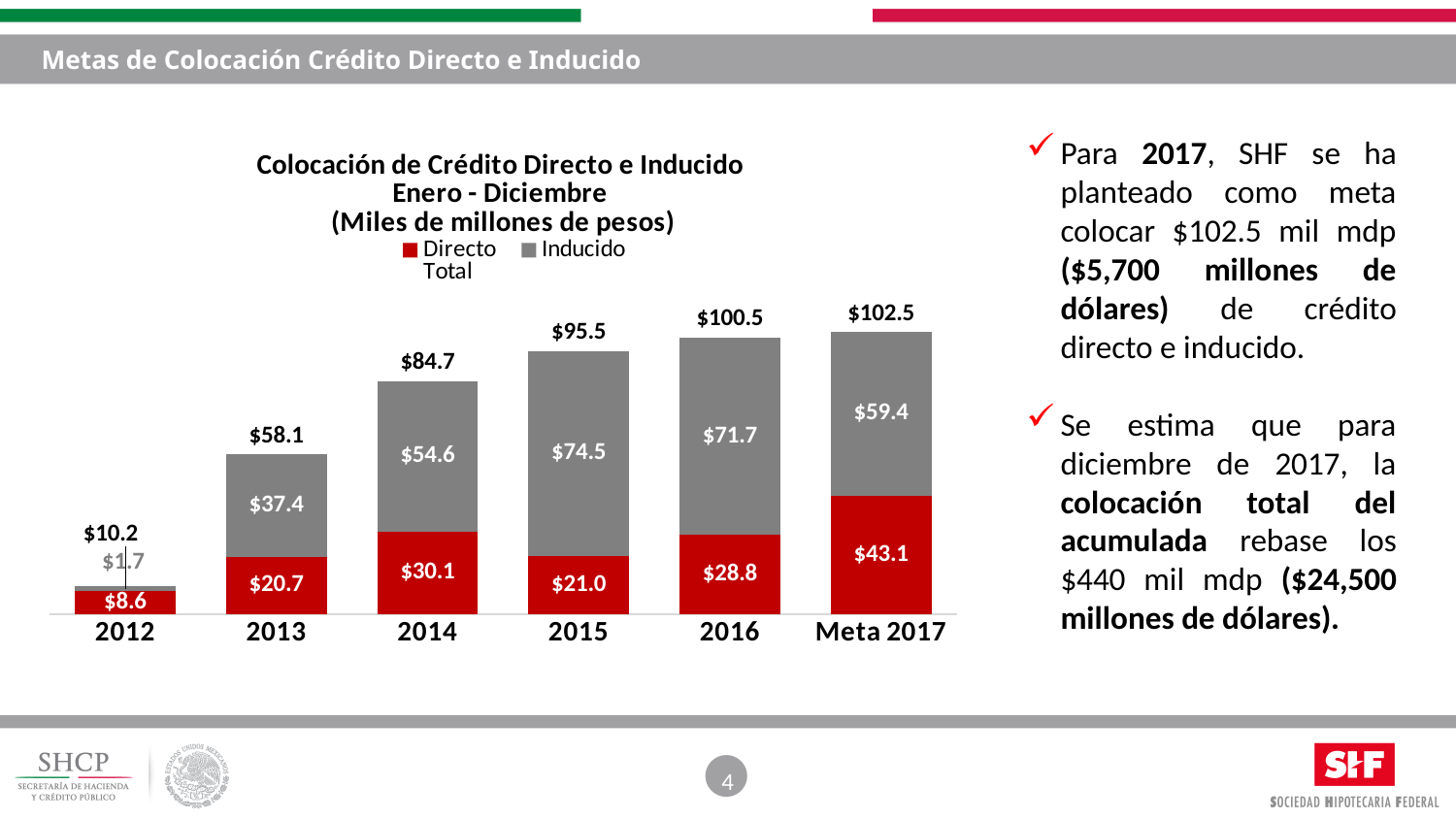
What is the unit stated in the chart title? Miles de millones de pesos What is the difference between the Directo values for Meta 2017 and 2016? $14.3 What is the Directo value for 2014? $30.1 How many categories are shown on the x axis? 6 Which is larger, the Inducido value for 2013 or the Inducido value for 2014? 2014 Do the totals rise or fall from 2012 to Meta 2017? Rise Which category has the highest Inducido value? 2015 Which category has the lowest total? 2012 What is the Inducido value for 2015? $74.5 What is the total shown above the bar for Meta 2017? $102.5 What kind of chart is shown on the slide? Stacked bar chart How many entries does the legend list? 3